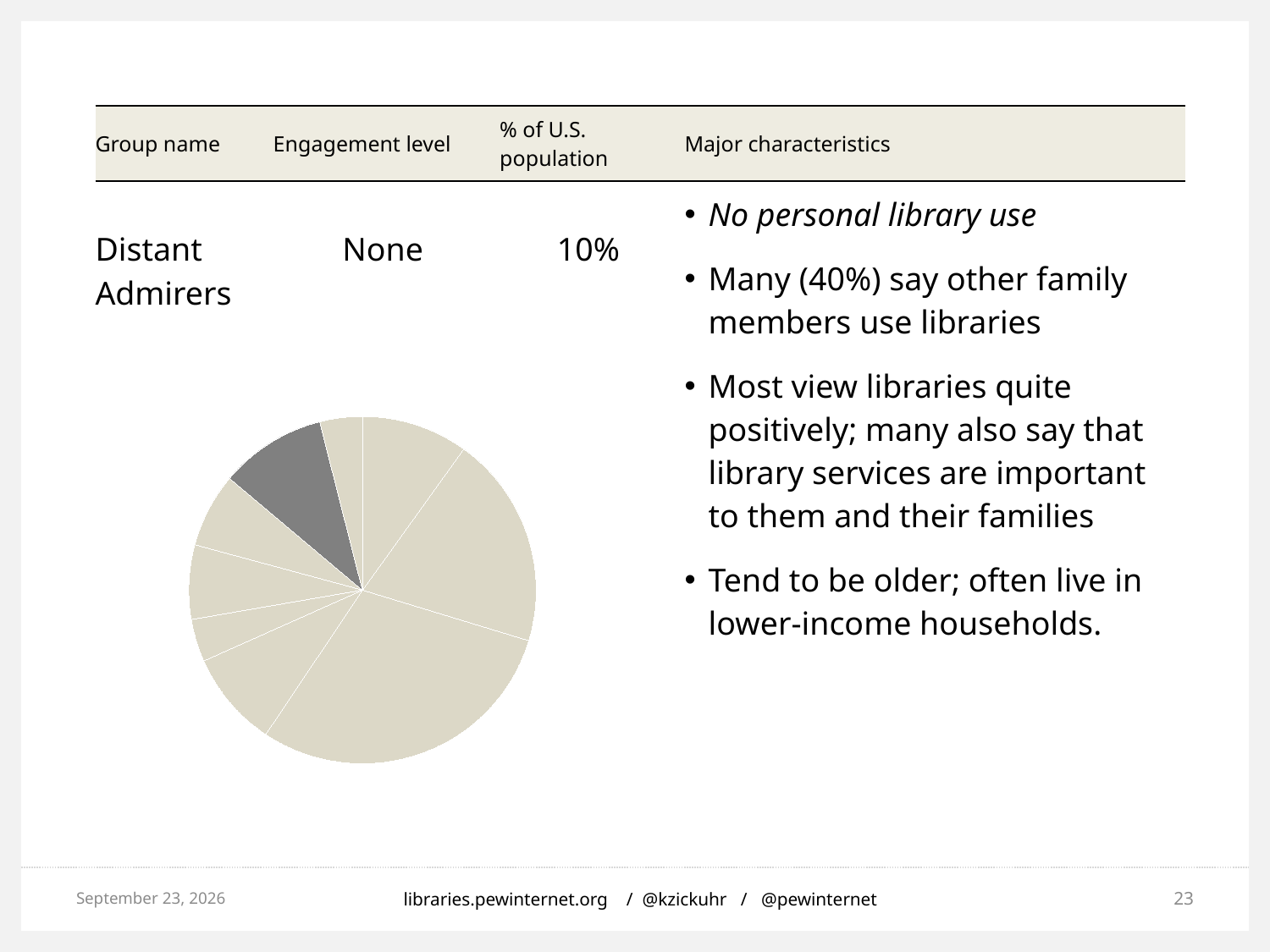
How many slices does the pie chart have? 9 What colour is the highlighted slice of the pie chart? dark gray Which group does the dark gray slice of the pie chart represent? Distant Admirers What kind of chart is shown on the slide? pie chart What share of the U.S. population does the highlighted dark gray slice of the pie chart represent? 10%